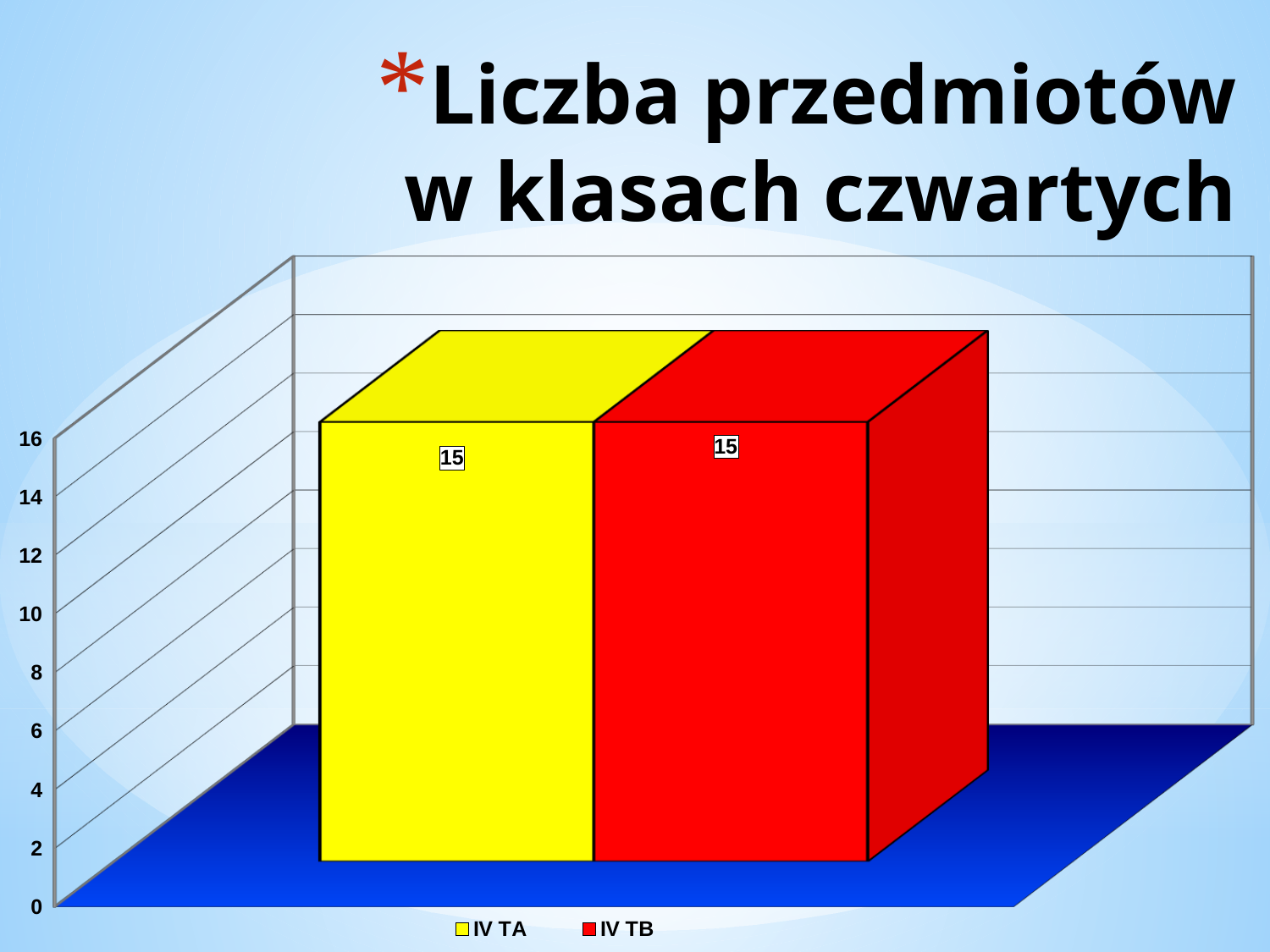
How many series does the legend list? 2 What is the value for IV TA? 15 What colour is the bar for IV TB? red Is the value for IV TB greater or less than 16? less What kind of chart is shown on the slide? bar chart How many bars are plotted on the chart? 2 Is the value for IV TA greater or less than 10? greater What is the title of the slide? Liczba przedmiotów w klasach czwartych What is the difference between the values for IV TA and IV TB? 0 What is the highest value shown on the vertical axis? 16 What is the value for IV TB? 15